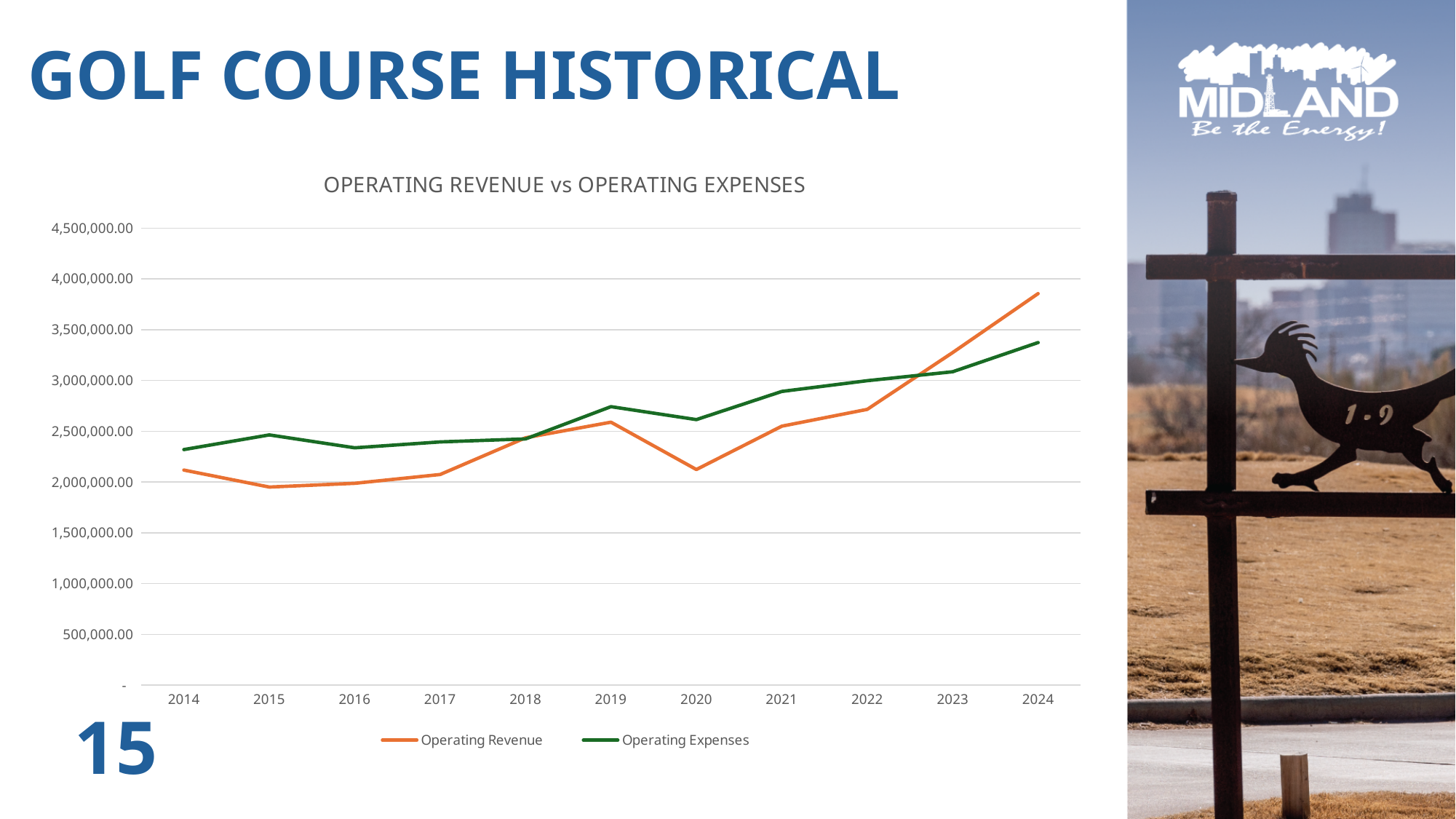
In which year is Operating Expenses highest? 2024 Is the Operating Expenses value for 2021 greater or less than 3,000,000.00? less In 2024, which is larger, Operating Revenue or Operating Expenses? Operating Revenue Overall, do Operating Expenses rise or fall from 2014 to 2024? rise How many years are plotted along the x axis? 11 What is the title of the chart? OPERATING REVENUE vs OPERATING EXPENSES Is the Operating Revenue value for 2024 greater or less than 3,500,000.00? greater In which year is Operating Revenue highest? 2024 What kind of chart is shown on the slide? line chart How many series does the legend list? 2 Is the Operating Expenses value for 2024 greater or less than 3,500,000.00? less In 2020, which is larger, Operating Revenue or Operating Expenses? Operating Expenses